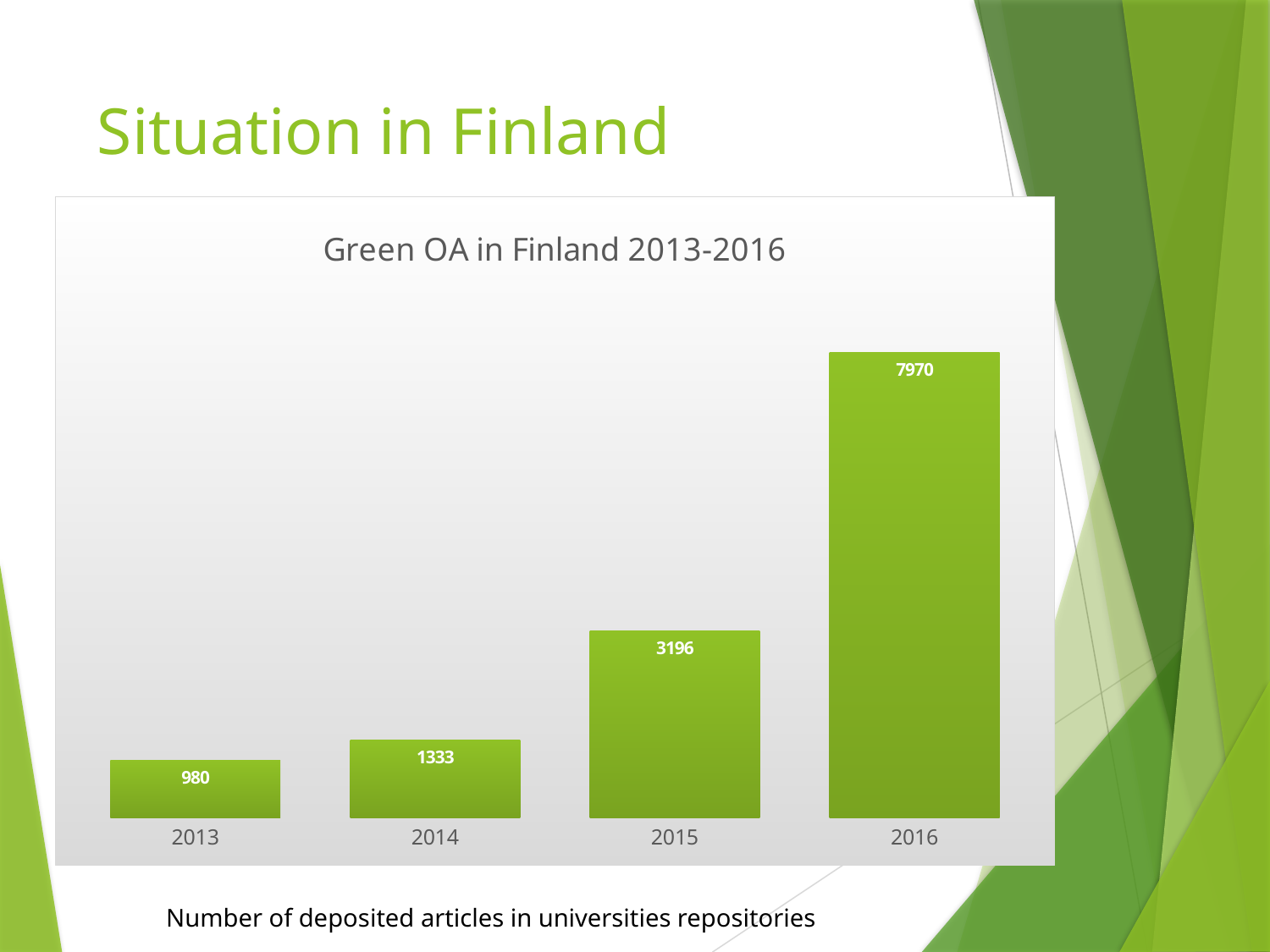
What is the value for 2015? 3196 Which year has the lowest value? 2013 What is the difference between the values for 2016 and 2015? 4774 Which is larger, the value for 2015 or the value for 2014? 2015 Which year has the highest value? 2016 What is the value for 2013? 980 How many years are shown on the x axis? 4 What is the value for 2014? 1333 What is the difference between the values for 2014 and 2013? 353 What is the value for 2016? 7970 Do the values rise or fall from 2013 to 2016? rise What kind of chart is shown? bar chart